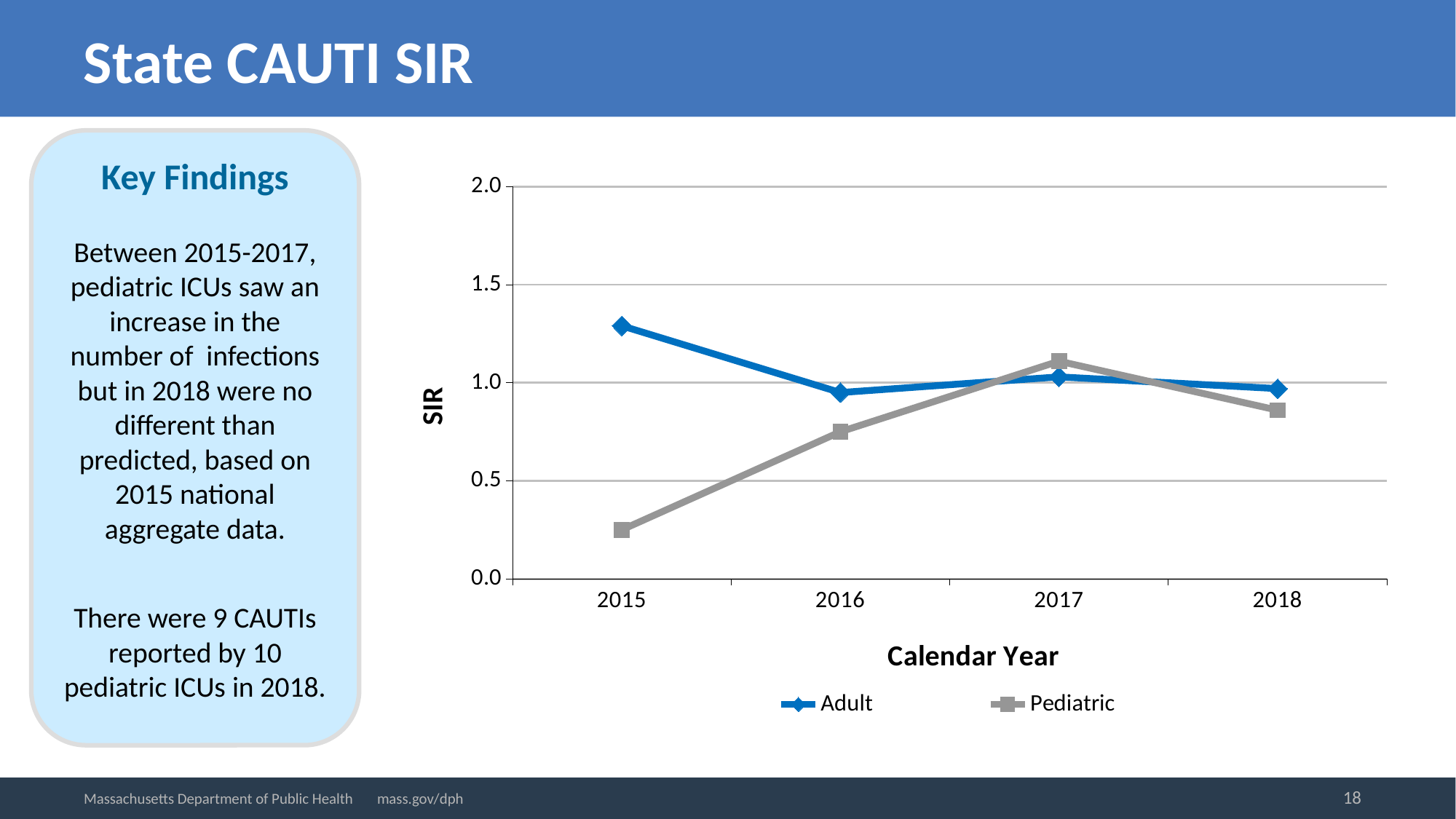
In 2015, which series has the higher SIR, Adult or Pediatric? Adult In which year is the Pediatric SIR highest? 2017 In which year is the Pediatric SIR lowest? 2015 Is the Pediatric SIR value for 2016 greater or less than 1.0? less Is the Pediatric SIR value for 2015 greater or less than 0.5? less Is the Pediatric SIR value for 2017 greater or less than 1.0? greater In 2018, which series has the higher SIR, Adult or Pediatric? Adult How many series does the legend list? 2 How many calendar years are plotted on the x axis? 4 What kind of chart is shown on the slide? Line chart Does the Pediatric SIR rise or fall from 2015 to 2017? Rise